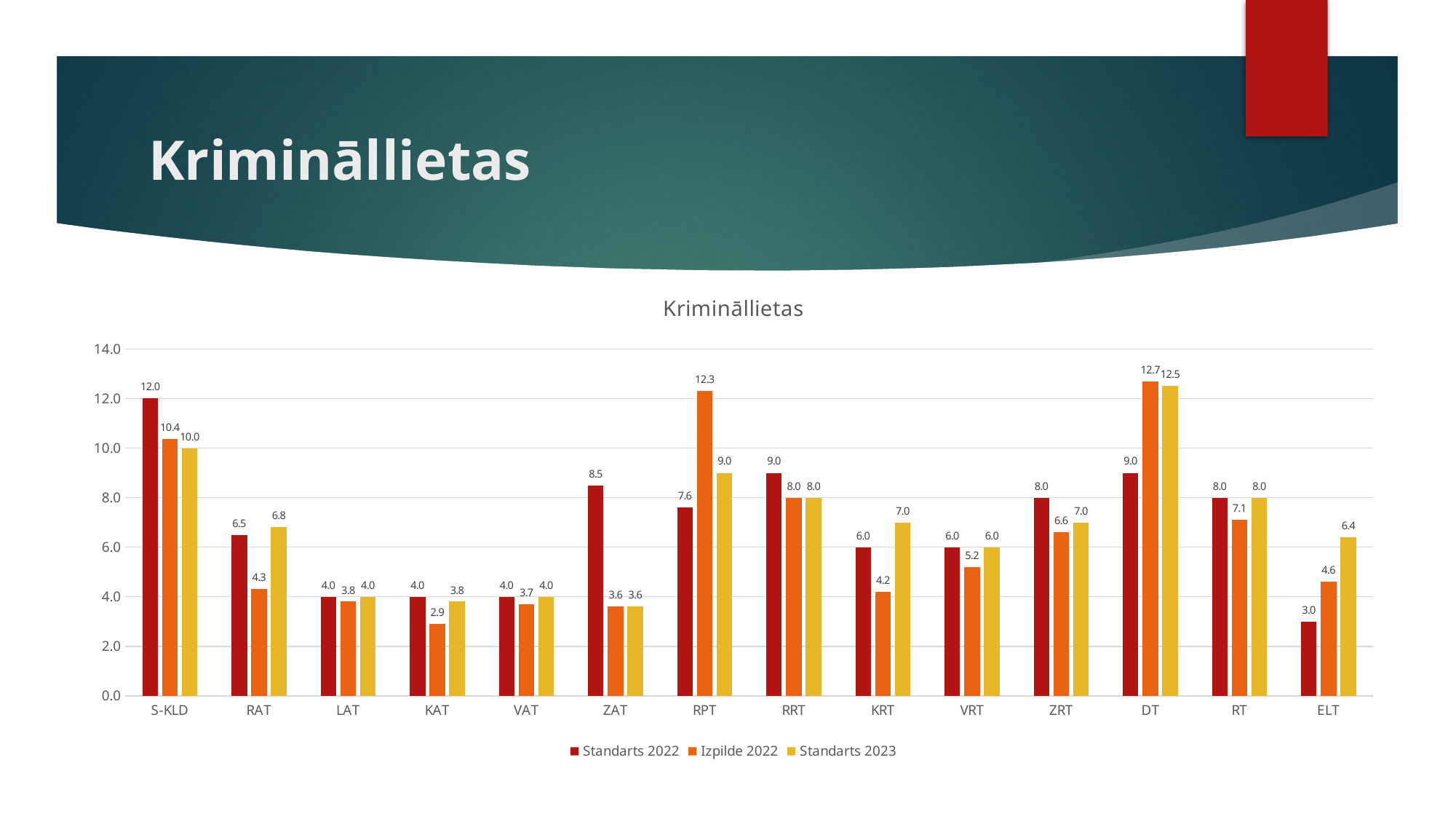
How many series does the legend list? 3 What is the title of the chart? Krimināllietas How many categories are shown on the x axis? 14 Which category has the lowest Standarts 2022 value? ELT What is the Standarts 2023 value for ELT? 6.4 What is the Izpilde 2022 value for RPT? 12.3 Which is larger for RAT: the Izpilde 2022 value or the Standarts 2023 value? Standarts 2023 What is the Standarts 2022 value for ZAT? 8.5 What kind of chart is shown on the slide? Bar chart What is the difference between the Standarts 2022 and Izpilde 2022 values for KRT? 1.8 Which category has the highest Izpilde 2022 value? DT Which series is shown in yellow? Standarts 2023